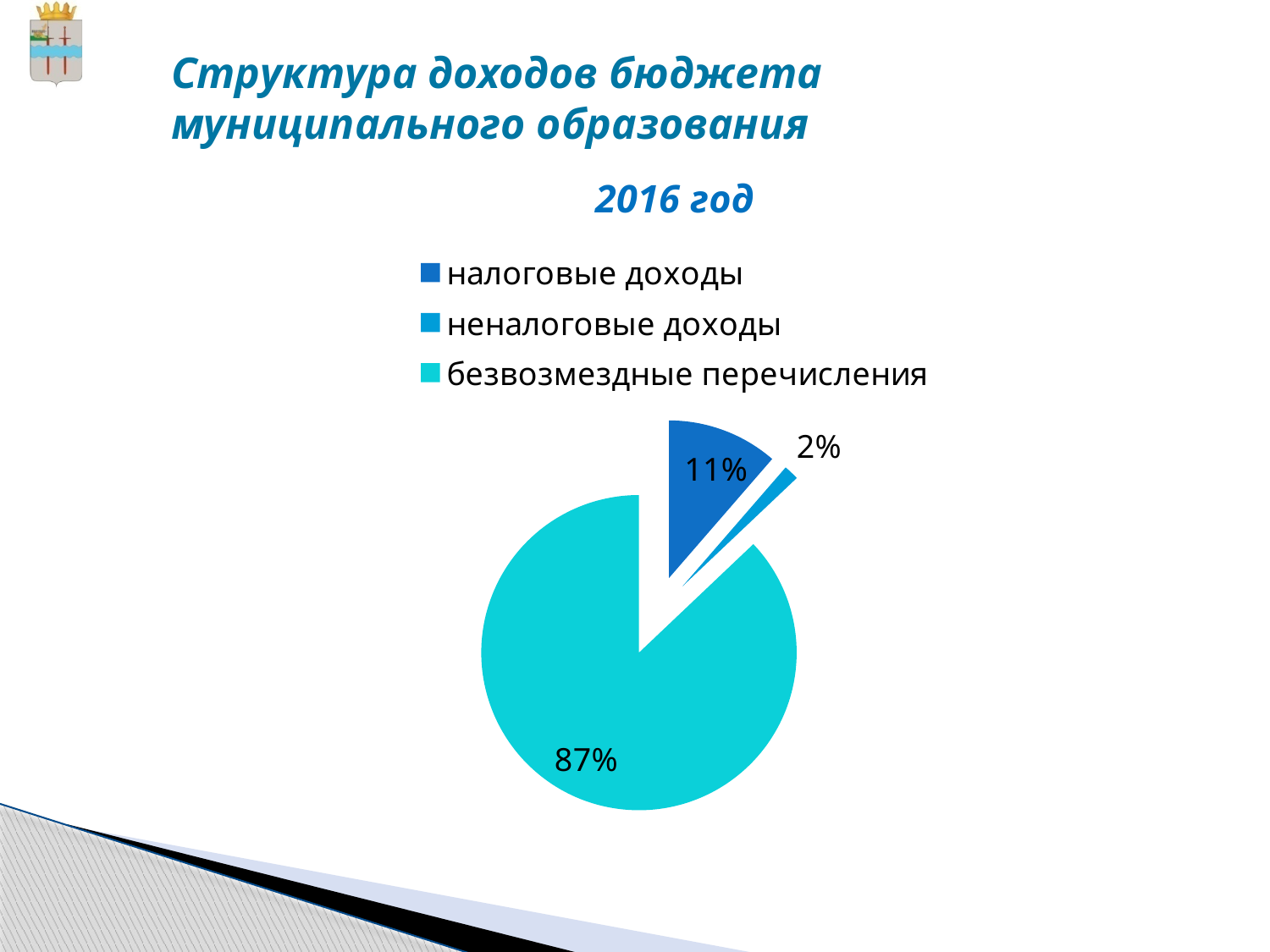
Which is larger, налоговые доходы or неналоговые доходы? налоговые доходы What share of the pie does налоговые доходы have? 11% What share of the pie does неналоговые доходы have? 2% What is the difference in percentage points between налоговые доходы and неналоговые доходы? 9 What share of the pie does безвозмездные перечисления have? 87% How many slices does the pie chart have? 3 What is the difference in percentage points between безвозмездные перечисления and налоговые доходы? 76 Which category has the largest slice of the pie? безвозмездные перечисления Which category has the smallest slice of the pie? неналоговые доходы How many entries does the legend list? 3 Which year does the chart title refer to? 2016 год What kind of chart is shown on the slide? pie chart